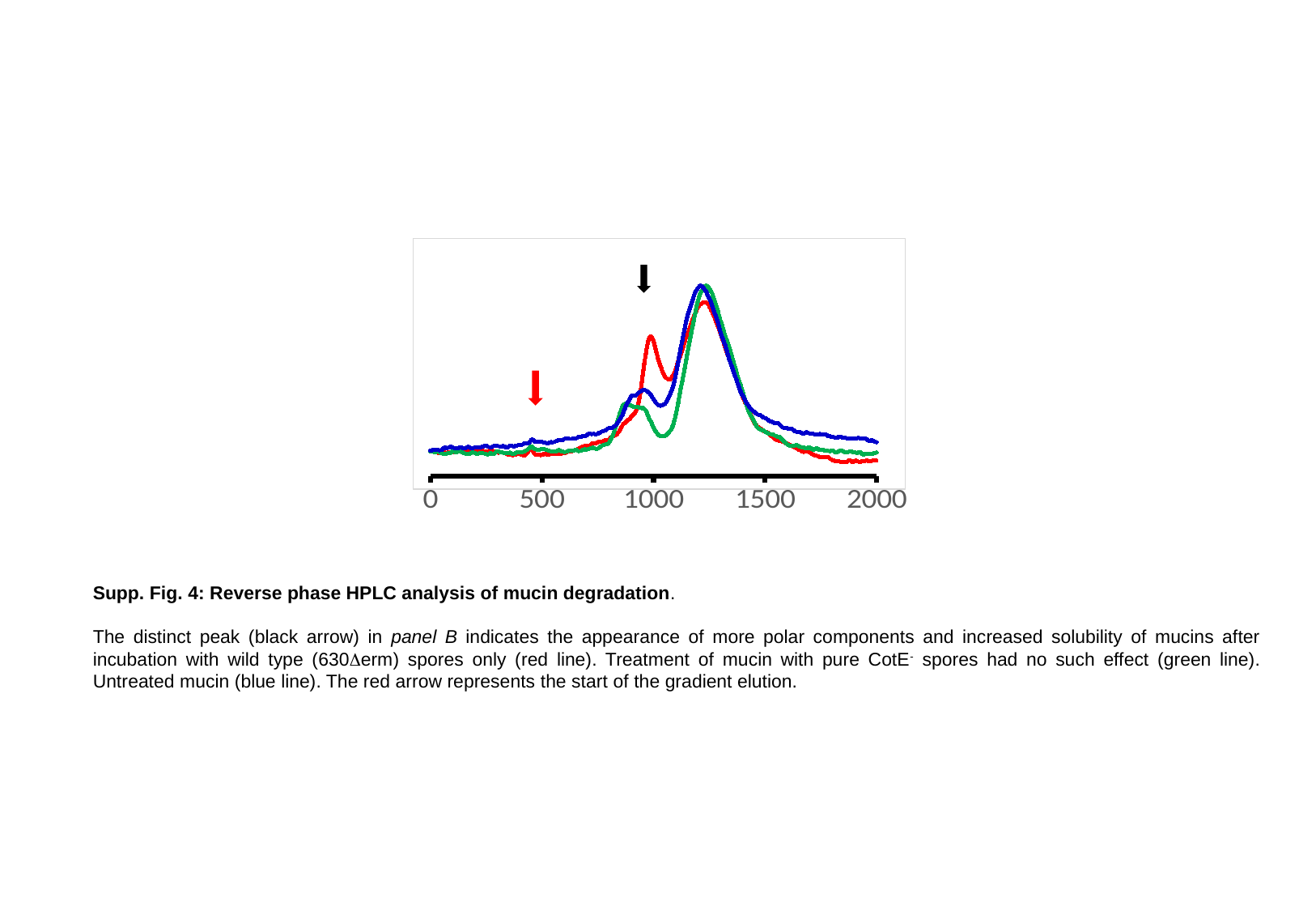
Which coloured line shows the distinct peak marked by the black arrow? red Which coloured line is lowest at the right-hand end of the chart, near x = 2000? red What colour is the arrow placed near x = 500 on the chart? red What is the largest value labelled on the x axis of the chart? 2000 Which coloured line is highest at the right-hand end of the chart, near x = 2000? blue How many tick labels are shown on the x axis of the chart? 5 Which coloured line reaches the lowest height at the main peak between 1000 and 1500? red How many lines are plotted on the chart? 3 Is the peak marked by the black arrow located at an x value greater or less than 500? greater Is the tallest peak shared by all three lines located at an x value greater or less than 1500? less Is the tallest peak shared by all three lines located at an x value greater or less than 1000? greater What kind of chart is shown on the slide? line chart